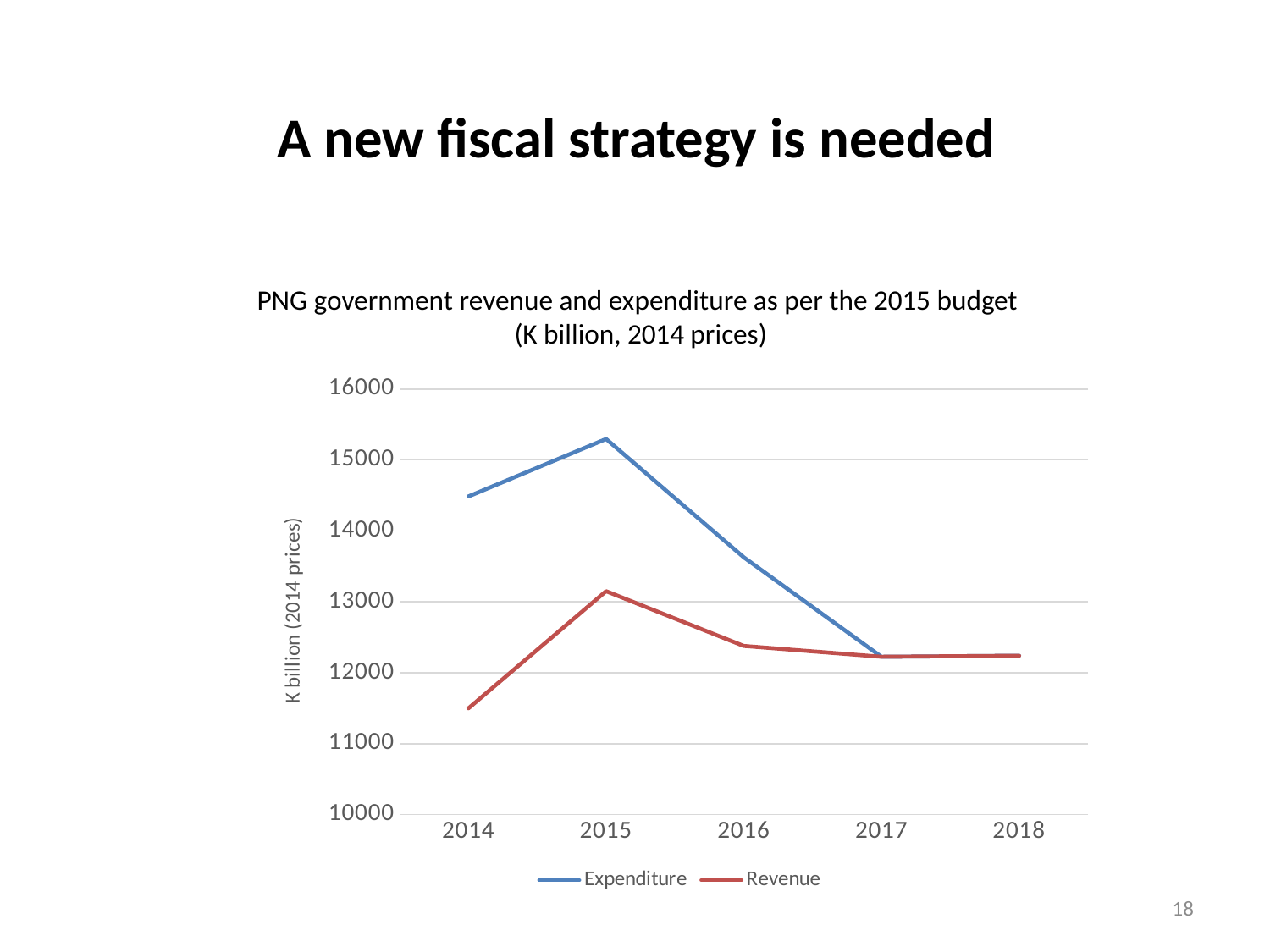
What kind of chart is shown on the slide? Line chart Is the value for Expenditure in 2015 greater or less than 15000? greater How many series does the legend list? 2 How many years are shown on the x axis? 5 Is the value for Expenditure in 2016 greater or less than 13000? greater In which year is Revenue highest? 2015 Which is larger in 2014, Expenditure or Revenue? Expenditure Does Expenditure rise or fall from 2015 to 2017? Fall Is the value for Revenue in 2014 greater or less than 12000? less What is the label on the vertical axis? K billion (2014 prices) In which year is Revenue lowest? 2014 In which year is Expenditure highest? 2015